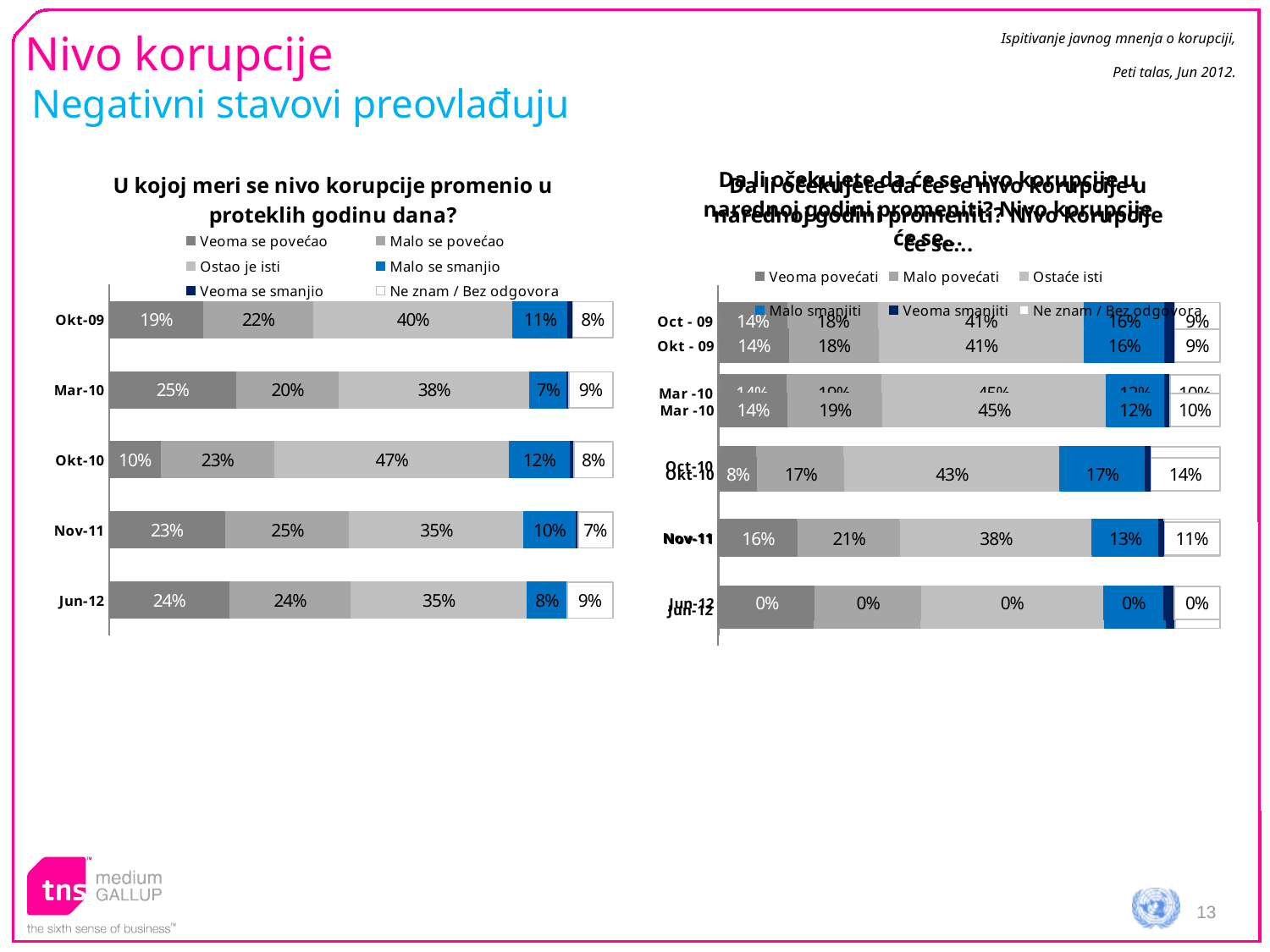
In the left chart ("U kojoj meri se nivo korupcije promenio u proteklih godinu dana?"), what is the value for "Ostao je isti" in Okt-10? 47% In the left chart, which is larger: "Malo se povećao" in Nov-11 or "Malo se povećao" in Okt-09? Nov-11 In the left chart, how many periods (bars) are shown? 5 In the left chart, what is the difference between the "Ostao je isti" values for Okt-10 and Nov-11? 12% In the left chart, what is the value for "Malo se smanjio" in Jun-12? 8% In the left chart, which period has the highest value for "Ostao je isti"? Okt-10 In the left chart, how many series does the legend list? 6 In the left chart, what is the value for "Malo se smanjio" in Mar-10? 7% In the left chart, what is the value for "Ne znam / Bez odgovora" in Nov-11? 7% In the left chart, what is the value for "Veoma se povećao" in Mar-10? 25% What type of chart is the left chart? Stacked bar chart In the left chart, which period has the lowest value for "Veoma se povećao"? Okt-10